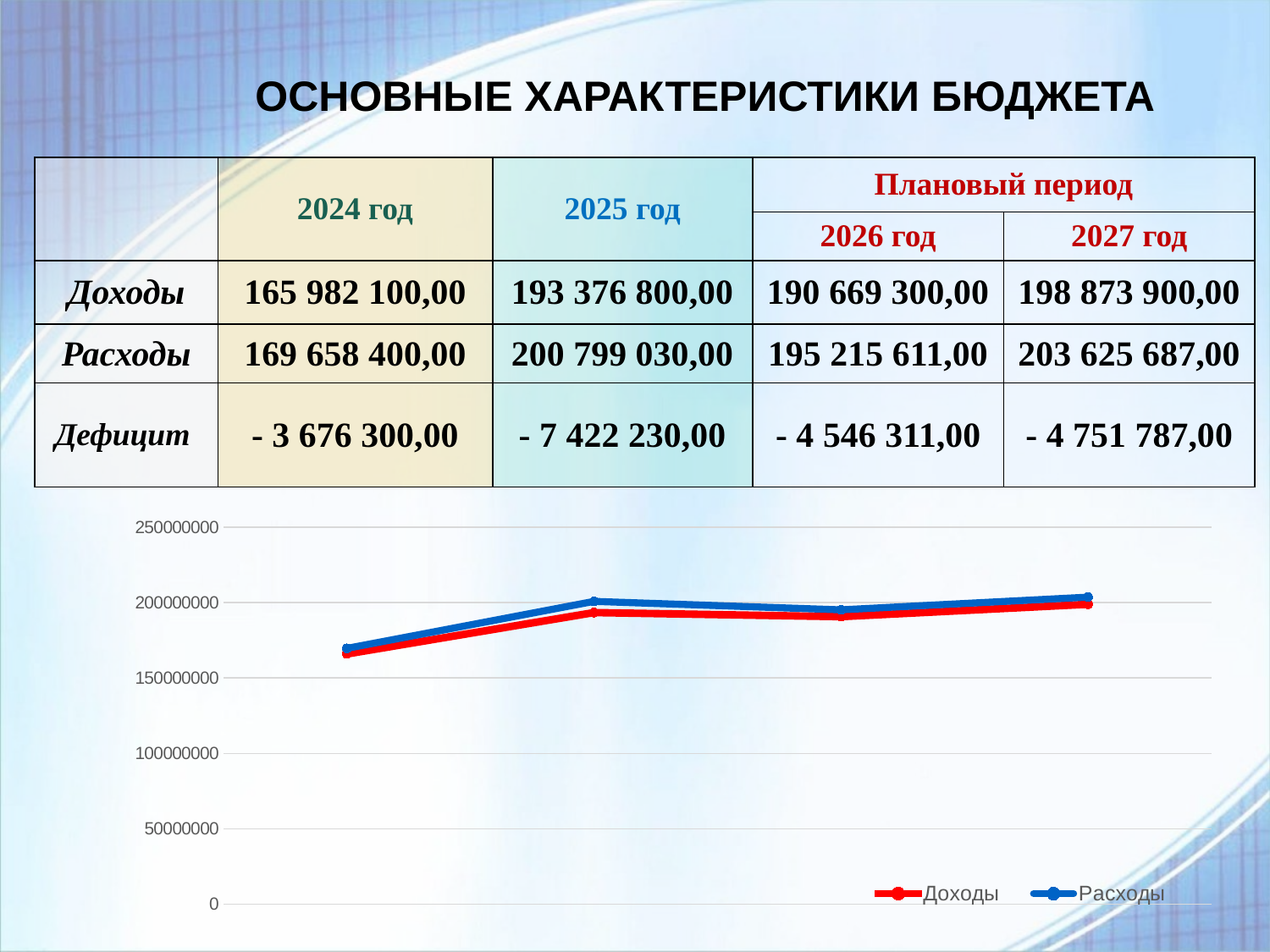
Do the lines in the chart rise or fall from the first point to the second point? rise How many data points does each line in the chart have? 4 Is the first point of the Доходы line greater or less than 150000000? greater Which series is higher at every point in the chart, Доходы or Расходы? Расходы Do the lines in the chart rise or fall from the second point to the third point? fall Which two series are listed in the chart legend? Доходы and Расходы What colour is the Расходы line in the chart? blue What is the highest value shown on the chart's vertical axis? 250000000 How many series does the chart legend list? 2 What kind of chart is shown on the slide? line chart Is the highest point of the Расходы line greater or less than 250000000? less Is the first point of the Расходы line greater or less than 200000000? less